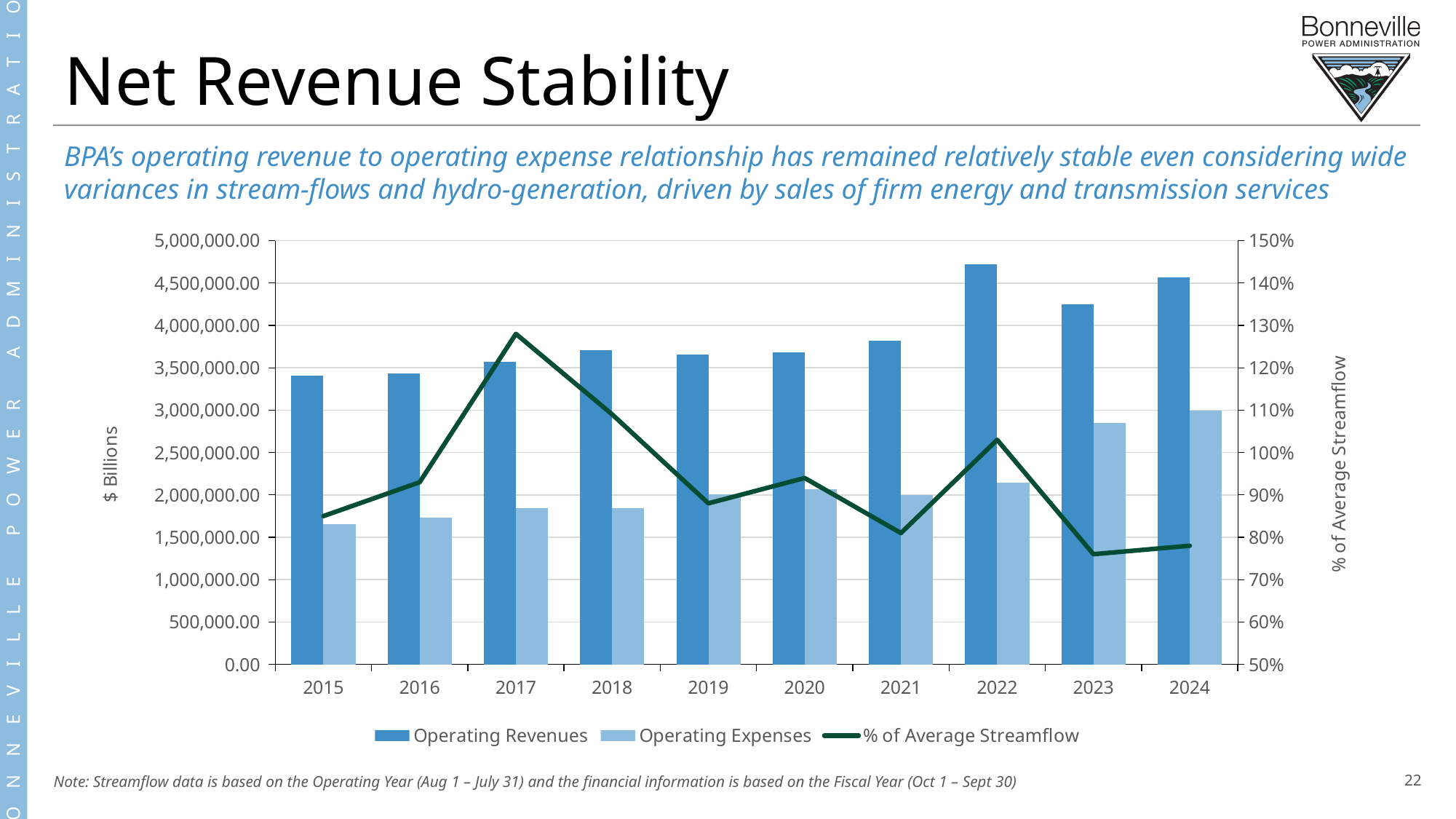
How many years are shown on the x axis? 10 Which year has the highest Operating Expenses? 2024 Which year has the lowest Operating Expenses? 2015 Is the Operating Expenses value for 2015 greater or less than 2,000,000.00? less Is the % of Average Streamflow for 2023 greater or less than 80%? less Which year has larger Operating Expenses, 2022 or 2023? 2023 How many series does the legend list? 3 In which year does the % of Average Streamflow line reach its peak? 2017 What is the label of the right-hand vertical axis? % of Average Streamflow Is the % of Average Streamflow for 2017 greater or less than 120%? greater Which year has the highest Operating Revenues? 2022